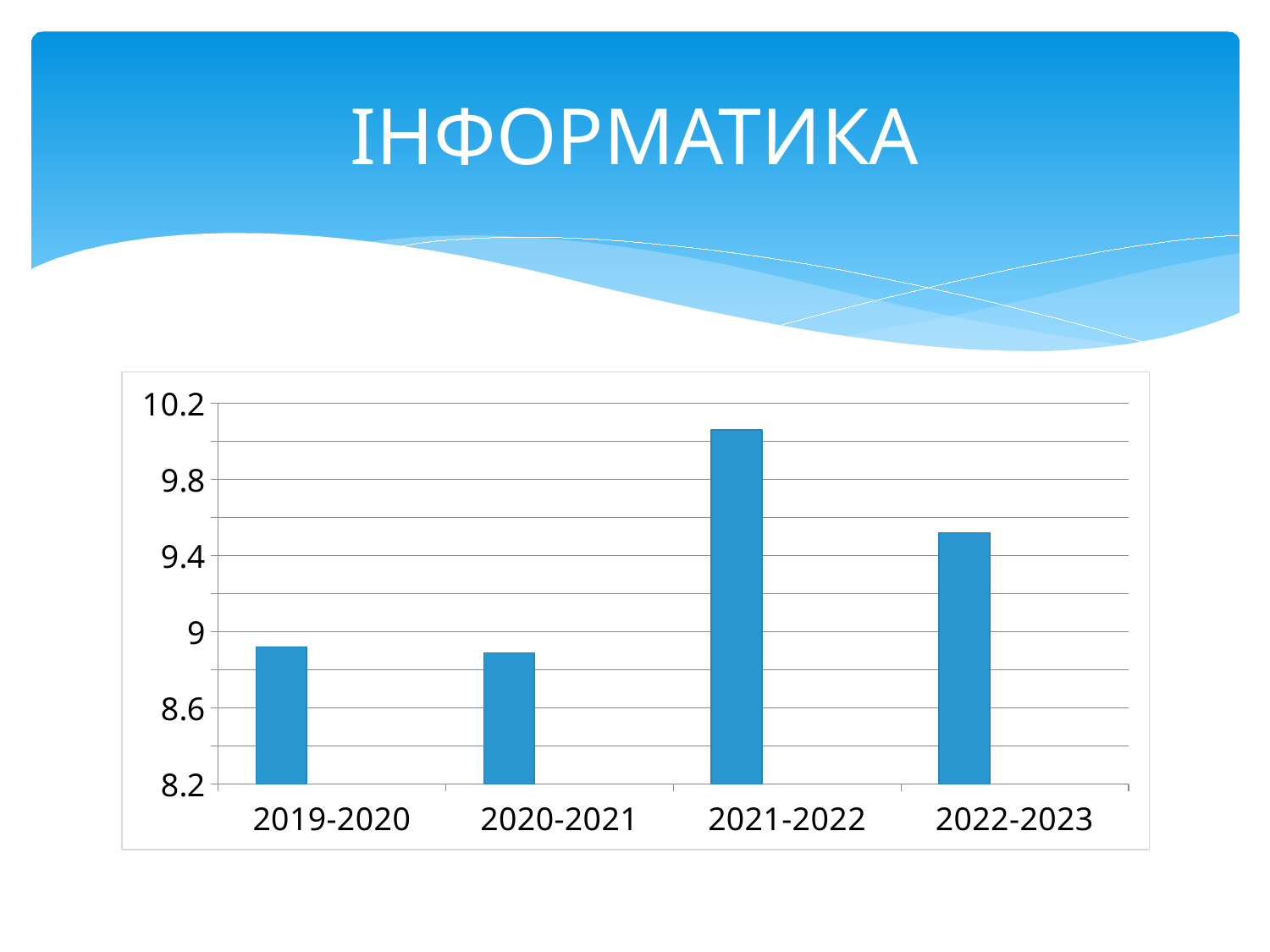
Which is larger, the value for 2022-2023 or the value for 2019-2020? 2022-2023 Is the value for 2019-2020 greater or less than 9? less Does the value rise or fall from 2020-2021 to 2021-2022? rise Is the value for 2020-2021 greater or less than 9? less What kind of chart is shown on the slide? bar chart Which is larger, the value for 2021-2022 or the value for 2022-2023? 2021-2022 How many categories (school years) are shown on the x axis? 4 Is the value for 2021-2022 greater or less than 9.8? greater Which school year has the highest value? 2021-2022 What is the title shown at the top of the slide? ІНФОРМАТИКА